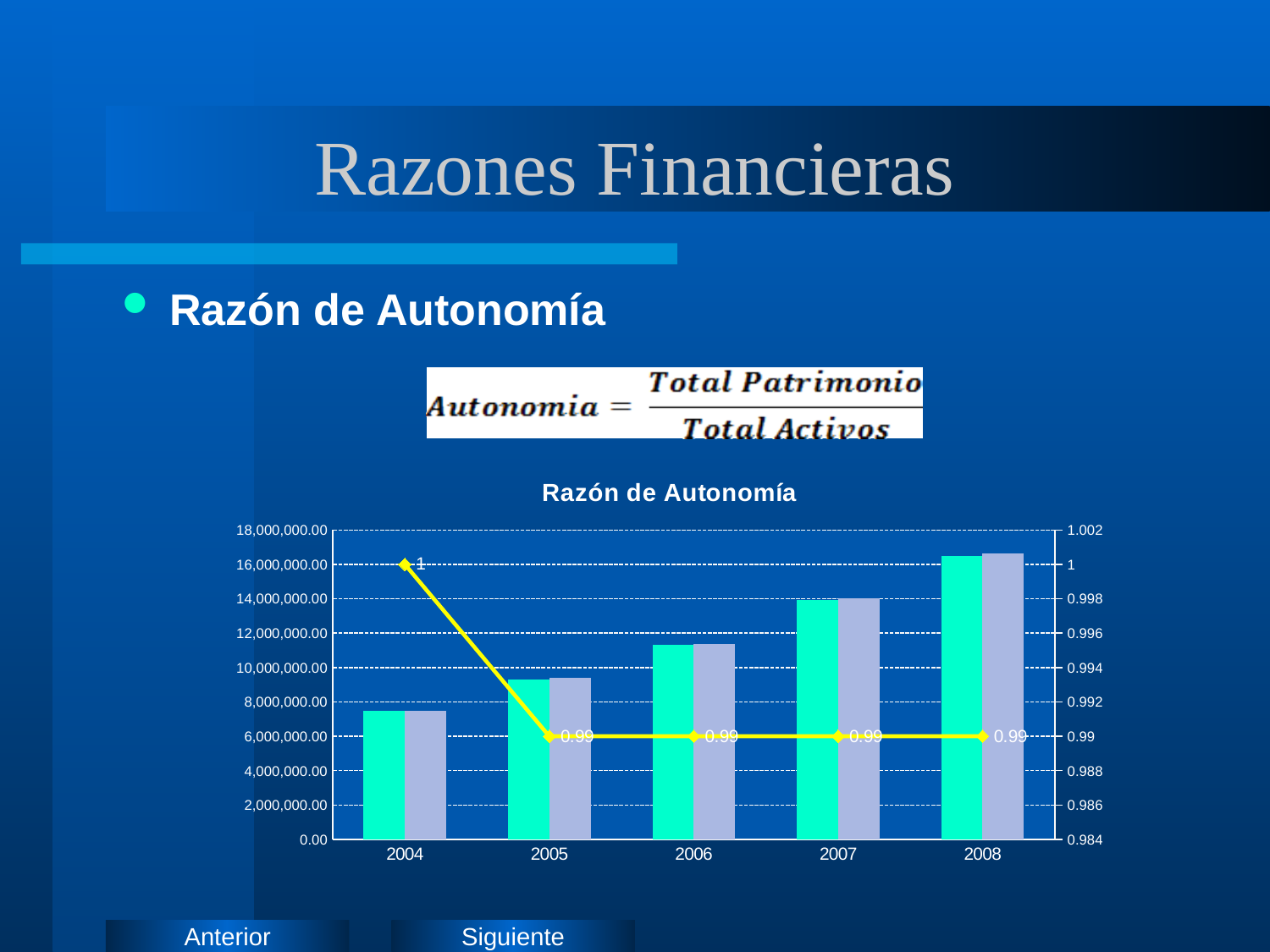
Which year has the shortest bars in the chart? 2004 What is the value shown on the line for 2004? 1 Is the bar value for 2008 greater or less than 16,000,000.00? greater Which year has larger bars, 2005 or 2007? 2007 What kind of chart is shown on the slide? A combination bar and line chart Is the bar value for 2004 greater or less than 8,000,000.00? less What is the difference between the line value for 2004 and the line value for 2005? 0.01 Do the bar values rise or fall from 2004 to 2008? Rise Which year has the tallest bars in the chart? 2008 What is the title of the chart? Razón de Autonomía What is the value shown on the line for 2007? 0.99 How many years are shown on the x axis of the chart? 5